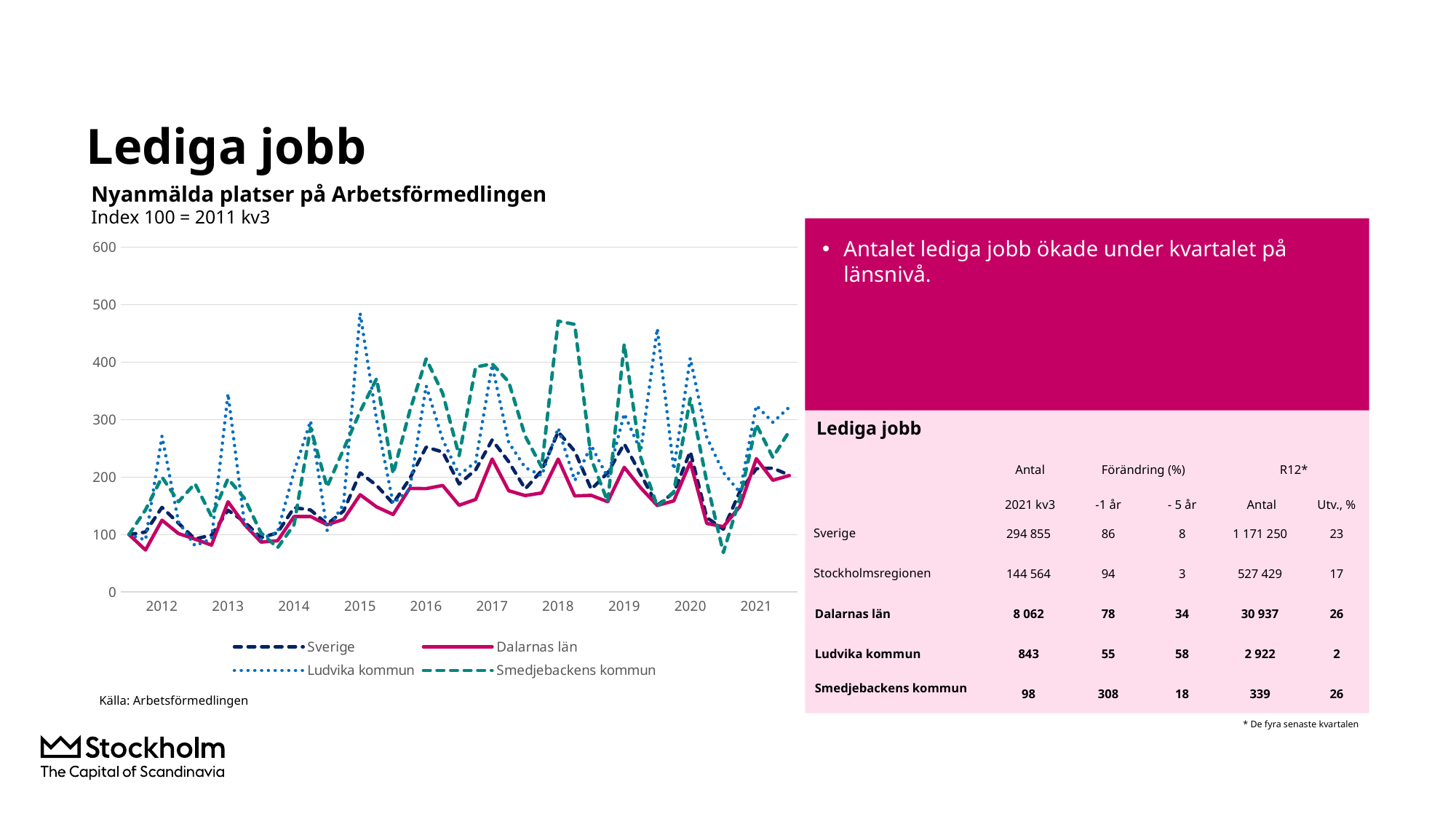
What is the subtitle of the chart? Nyanmälda platser på Arbetsförmedlingen What is the highest tick value shown on the y axis of the chart? 600 What is the index base stated under the chart subtitle? Index 100 = 2011 kv3 Which series reaches a higher peak on the chart, Dalarnas län or Ludvika kommun? Ludvika kommun Does the Dalarnas län line rise or fall overall from 2012 to 2021? rise How many years are labelled on the x axis of the chart? 10 What kind of chart is shown on the slide? line chart Is the peak value of Smedjebackens kommun in 2018 greater or less than 400? greater Is the highest value reached by Dalarnas län greater or less than 300? less Is the peak value of Ludvika kommun in 2015 greater or less than 400? greater How many series does the chart legend list? 4